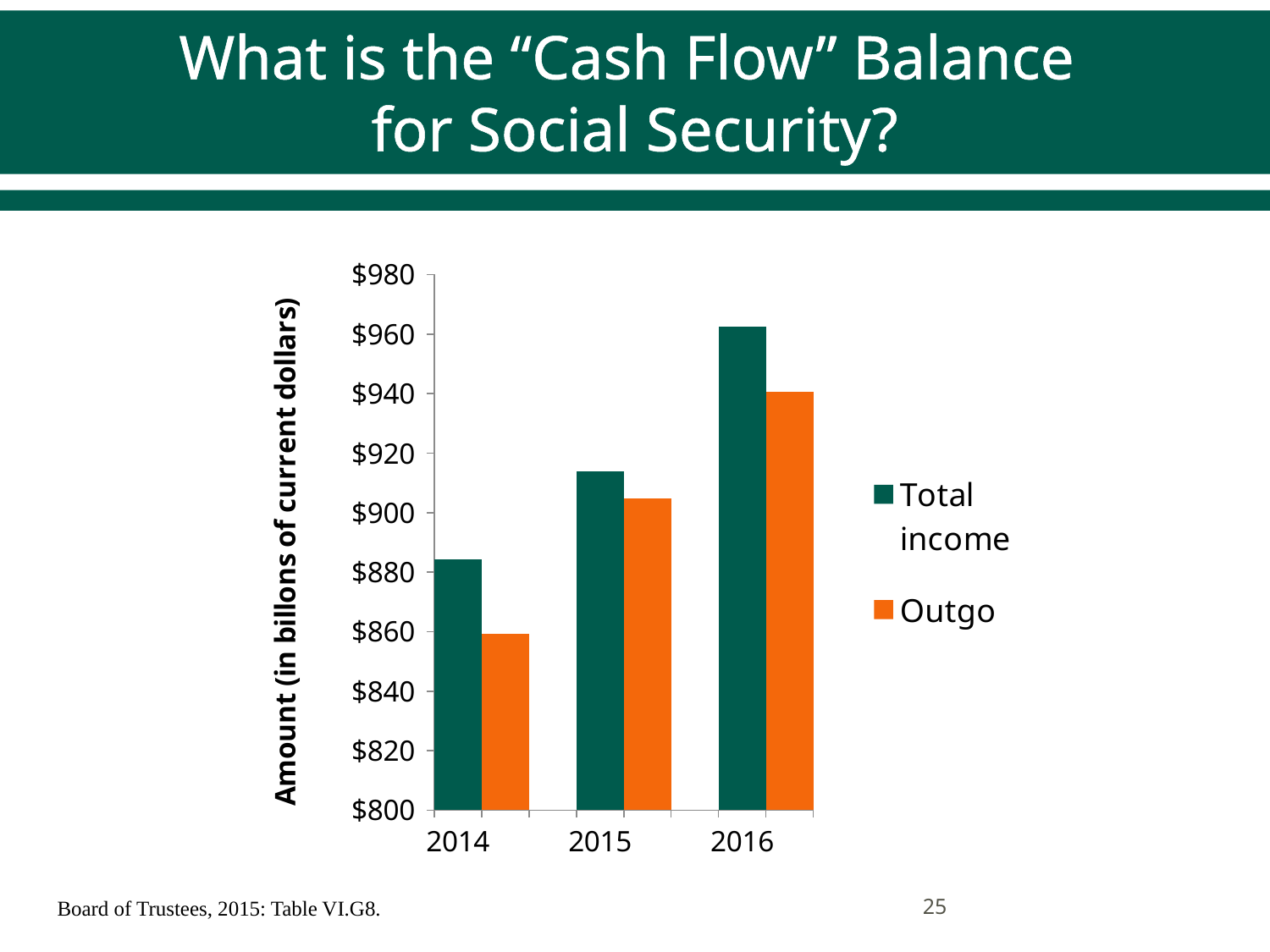
In 2016, which is larger, Total income or Outgo? Total income Is the Outgo value for 2016 greater or less than $960? less Is the Total income value for 2014 greater or less than $900? less What kind of chart is shown on the slide? bar chart What is the title of the vertical axis? Amount (in billons of current dollars) How many years are shown on the x axis? 3 Does Total income rise or fall from 2014 to 2016? rise Which year has the highest Total income? 2016 In 2014, which is larger, Total income or Outgo? Total income How many series does the legend list? 2 Which year has the lowest Outgo? 2014 Is the Total income value for 2015 greater or less than $900? greater